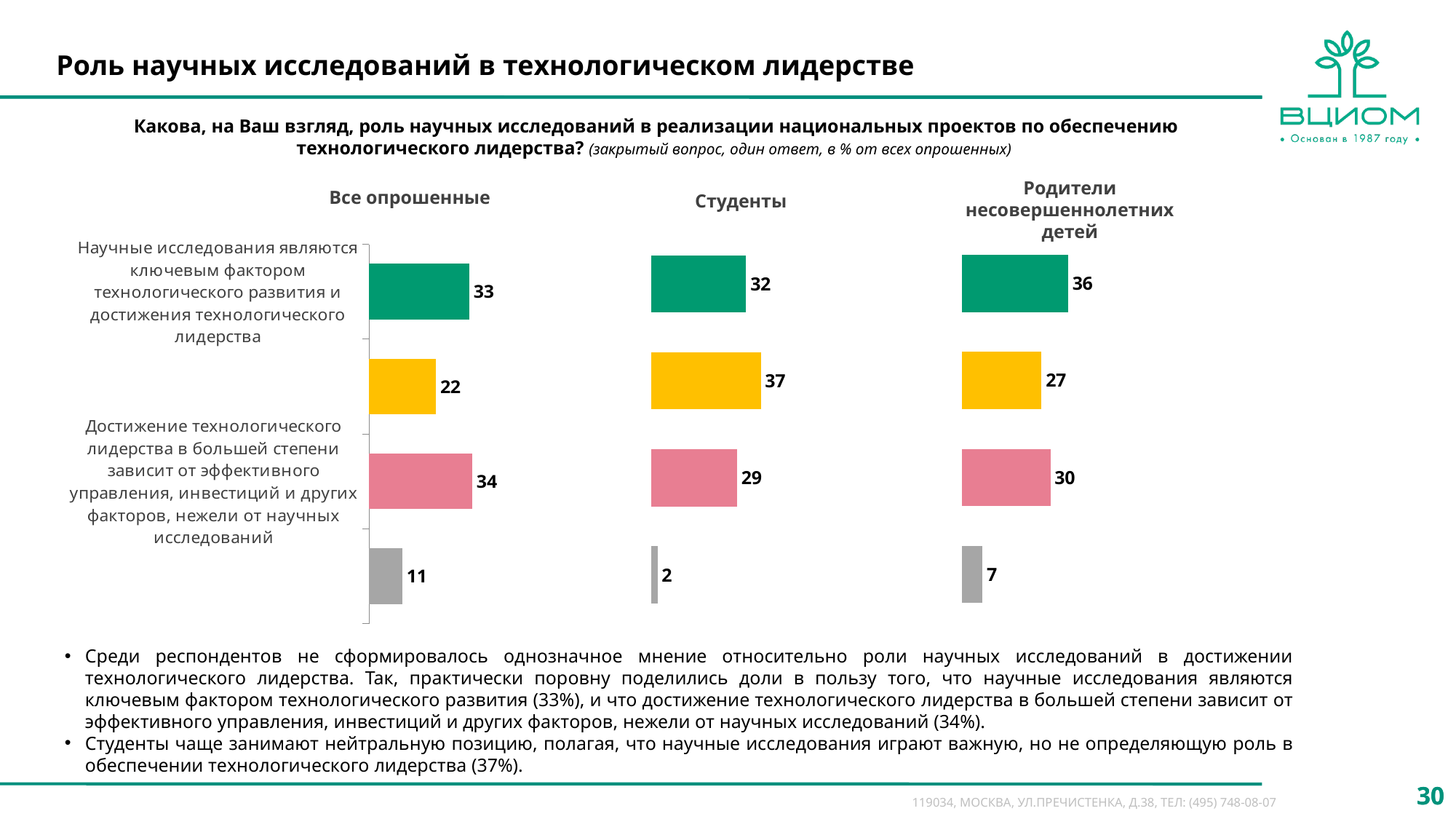
In the "Все опрошенные" chart, what is the value for "Научные исследования являются ключевым фактором технологического развития и достижения технологического лидерства"? 33 How many bars does the "Все опрошенные" chart contain? 4 In the "Студенты" chart, which bar has the lowest value? The grey bar (2) In the "Родители несовершеннолетних детей" chart, which bar has the highest value? The green bar (36) In the "Все опрошенные" chart, what is the difference between the pink bar (34) and the yellow bar (22)? 12 What type of chart is used on this slide? Bar chart In the "Студенты" chart, what is the value for "Достижение технологического лидерства в большей степени зависит от эффективного управления, инвестиций и других факторов, нежели от научных исследований"? 29 In the "Родители несовершеннолетних детей" chart, what is the value of the green bar ("Научные исследования являются ключевым фактором...")? 36 What is the difference between the grey bar values in the "Все опрошенные" chart (11) and the "Студенты" chart (2)? 9 How many separate charts are shown on the slide? 3 In the "Студенты" chart, what is the value of the yellow bar? 37 Which is larger: the value for "Научные исследования являются ключевым фактором..." in the "Студенты" chart or in the "Родители несовершеннолетних детей" chart? Родители несовершеннолетних детей (36)